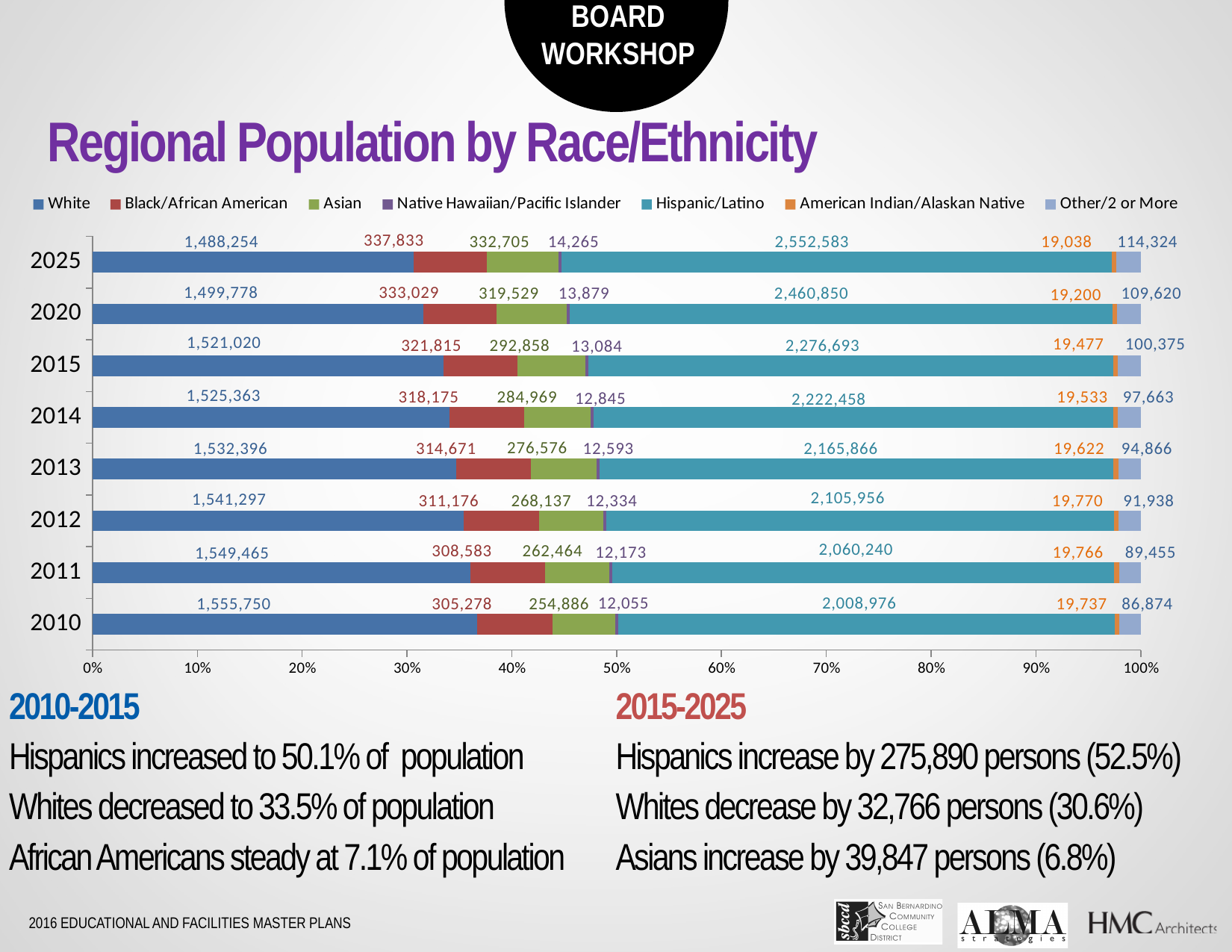
What is the Asian population value shown for 2015? 292,858 What is the difference between the Hispanic/Latino values for 2025 and 2015? 275,890 What is the Hispanic/Latino population value shown for 2010? 2,008,976 What is the White population value shown for 2025? 1,488,254 How many series does the legend list? 7 Which year has the lowest White value? 2025 In 2020, which is larger: the Black/African American value or the Asian value? Black/African American Which year has the highest Hispanic/Latino value? 2025 What is the American Indian/Alaskan Native value shown for 2014? 19,533 How many years are shown on the chart? 8 What kind of chart is shown on the slide? Stacked bar chart Do the White population values rise or fall from 2010 to 2025? Fall